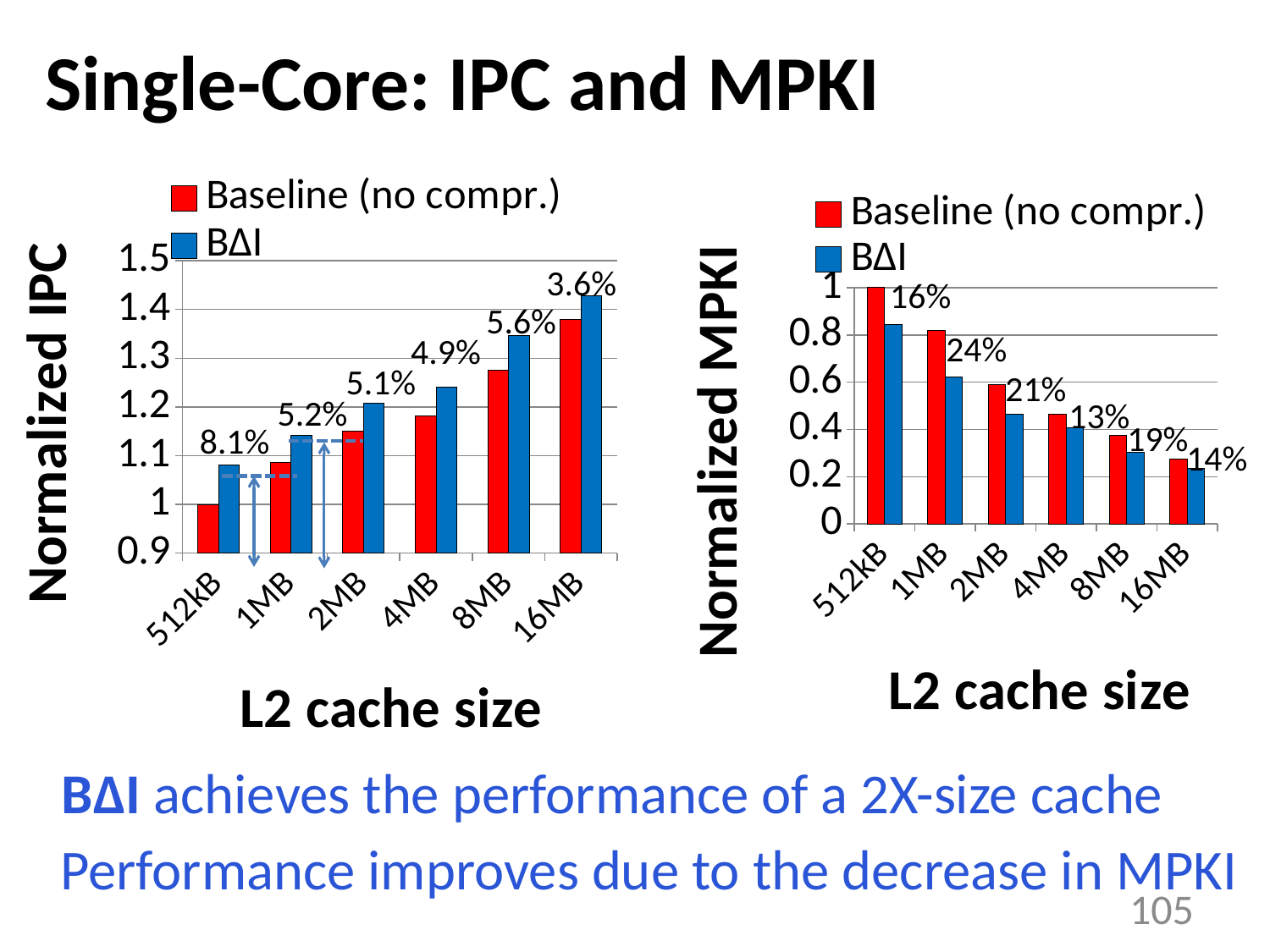
On the Normalized MPKI chart, which is larger at 1MB: Baseline (no compr.) or BΔI? Baseline (no compr.) On the Normalized IPC chart, do the BΔI values rise or fall as the L2 cache size increases? rise What is the x-axis title of the Normalized MPKI chart? L2 cache size On the Normalized IPC chart, what percentage label is shown above the 512kB bars? 8.1% What kind of chart is the Normalized IPC chart on the left? bar chart On the Normalized IPC chart, which cache size has the smallest percentage label? 16MB On the Normalized MPKI chart, is the Baseline (no compr.) value for 8MB greater or less than 0.4? less How many L2 cache size categories are shown on the Normalized IPC chart? 6 On the Normalized MPKI chart, what percentage label is shown next to the 1MB bars? 24% On the Normalized IPC chart, is the Baseline (no compr.) value for 8MB greater or less than 1.3? less How many series does the legend of the Normalized IPC chart list? 2 On the Normalized MPKI chart, which cache size has the largest percentage label? 1MB